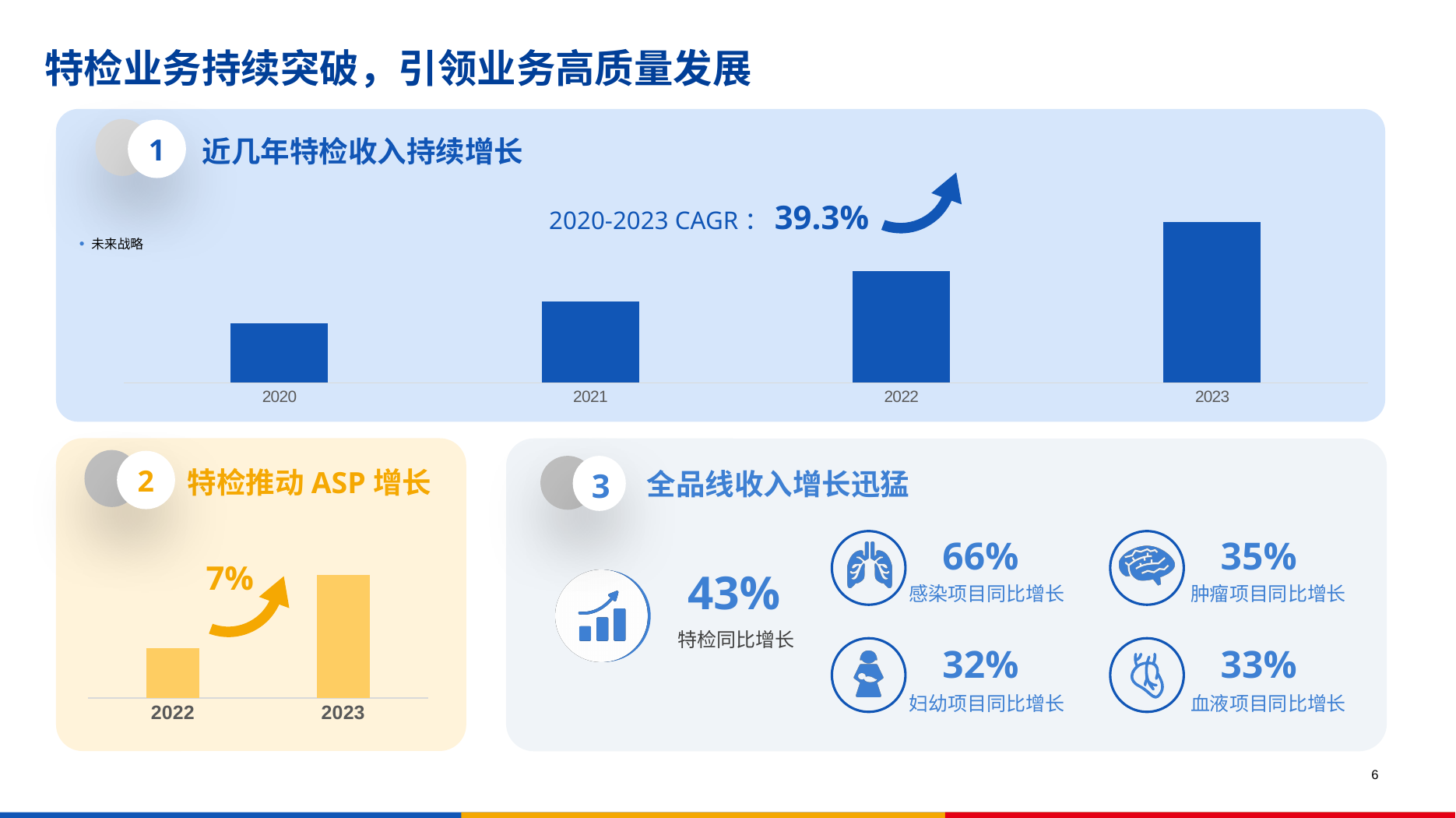
In the top bar chart (近几年特检收入持续增长), which bar is taller, 2021 or 2022? 2022 In the bottom-left chart (特检推动 ASP 增长), which year has the taller bar? 2023 What kind of chart is shown in the bottom-left panel titled 特检推动 ASP 增长? bar chart What growth percentage is annotated above the bars in the bottom-left chart (特检推动 ASP 增长)? 7% What 2020-2023 CAGR is stated on the top bar chart (近几年特检收入持续增长)? 39.3% In the top bar chart (近几年特检收入持续增长), which year has the tallest bar? 2023 How many years are plotted in the top bar chart (近几年特检收入持续增长)? 4 How many bars are in the bottom-left chart (特检推动 ASP 增长)? 2 In the top bar chart (近几年特检收入持续增长), which year has the shortest bar? 2020 In the top bar chart (近几年特检收入持续增长), do the bars rise or fall from 2020 to 2023? rise In the bottom-left chart (特检推动 ASP 增长), does the value rise or fall from 2022 to 2023? rise What kind of chart is shown in the top panel titled 近几年特检收入持续增长? bar chart